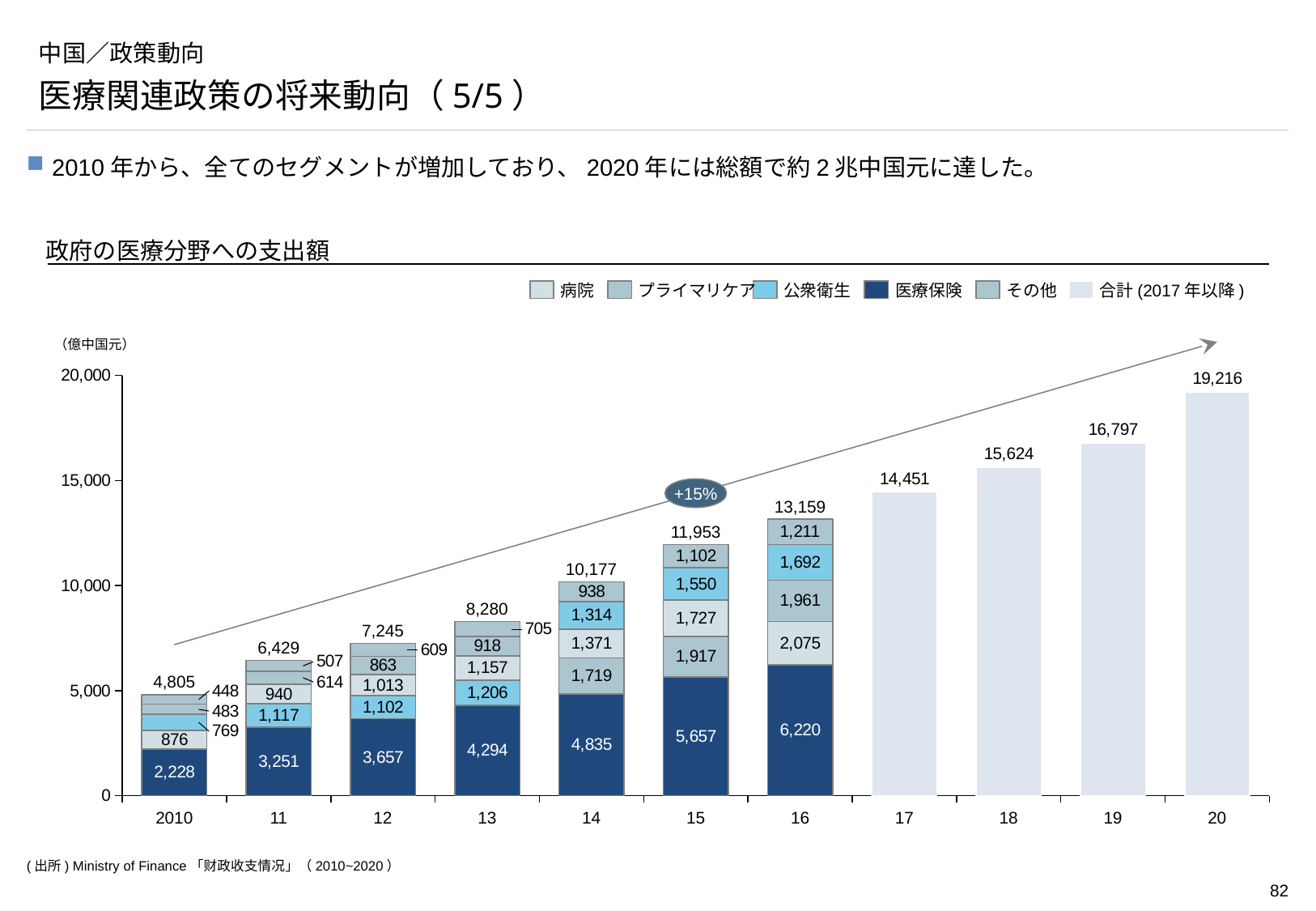
What is the value of the 医療保険 segment in 2016? 6,220 How many years are shown on the x axis? 11 Which year has the highest total spending? 2020 What is the total value shown for 2010? 4,805 What is the value of the 医療保険 segment in 2010? 2,228 What annual growth rate is annotated on the arrow in the chart? +15% What is the difference between the totals for 2020 and 2019? 2,419 How many series does the legend list? 6 What kind of chart is shown on the slide? stacked bar chart Which year has the lowest total spending? 2010 What is the total government healthcare spending shown for 2020? 19,216 Do the total values rise or fall from 2010 to 2020? rise